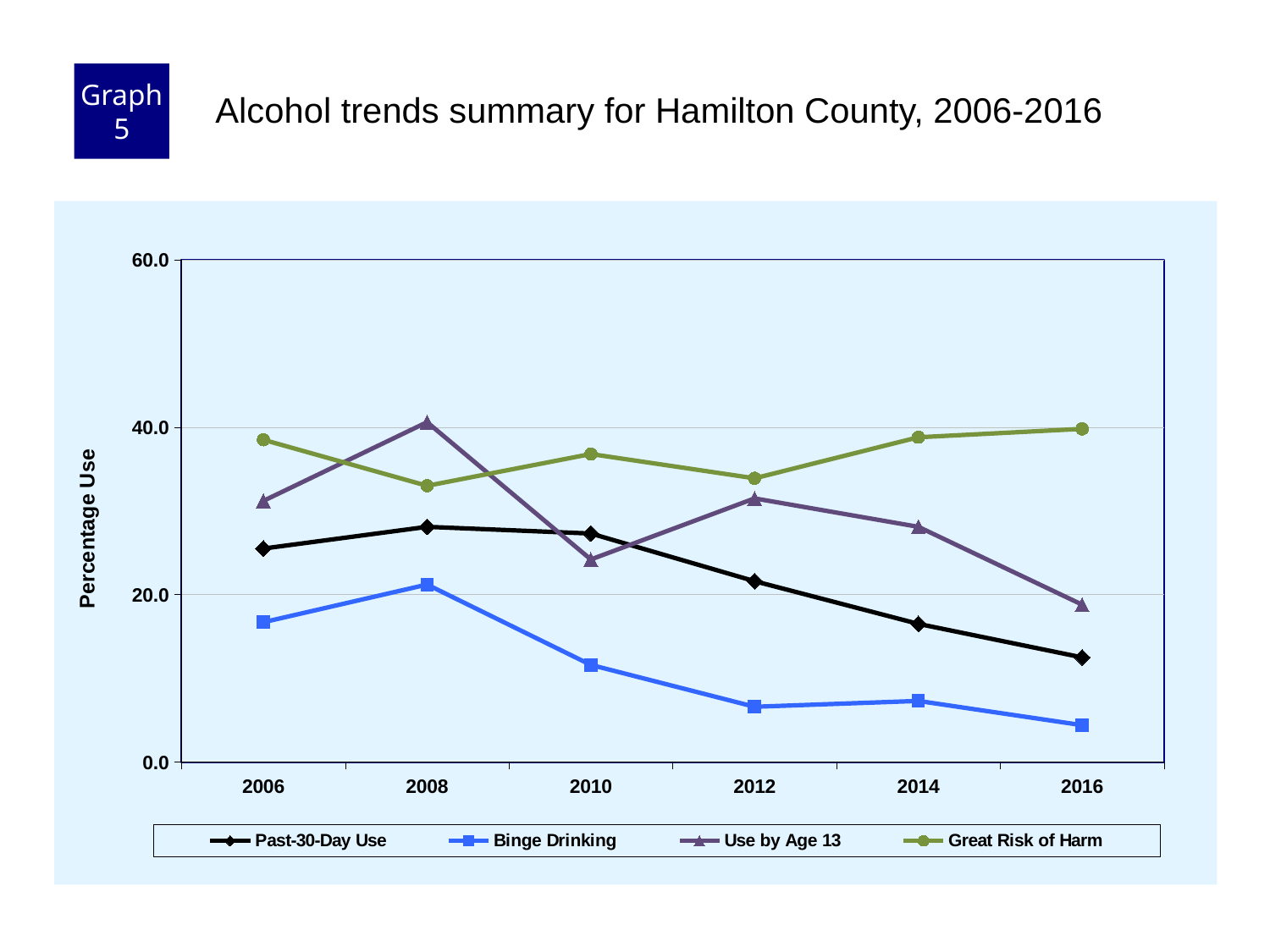
How many series does the legend list? 4 Is the value for Past-30-Day Use in 2006 greater or less than 20? greater In which year is Use by Age 13 lowest? 2016 What kind of chart is shown on the slide? Line chart In which year is Past-30-Day Use lowest? 2016 Is the value for Great Risk of Harm in 2008 greater or less than 40? less Does the Past-30-Day Use line rise or fall from 2008 to 2016? Fall What is the label on the y axis? Percentage Use How many years are plotted along the x axis? 6 In 2010, which is larger: Past-30-Day Use or Use by Age 13? Past-30-Day Use Does the Binge Drinking line generally rise or fall from 2006 to 2016? Fall In which year is Binge Drinking highest? 2008